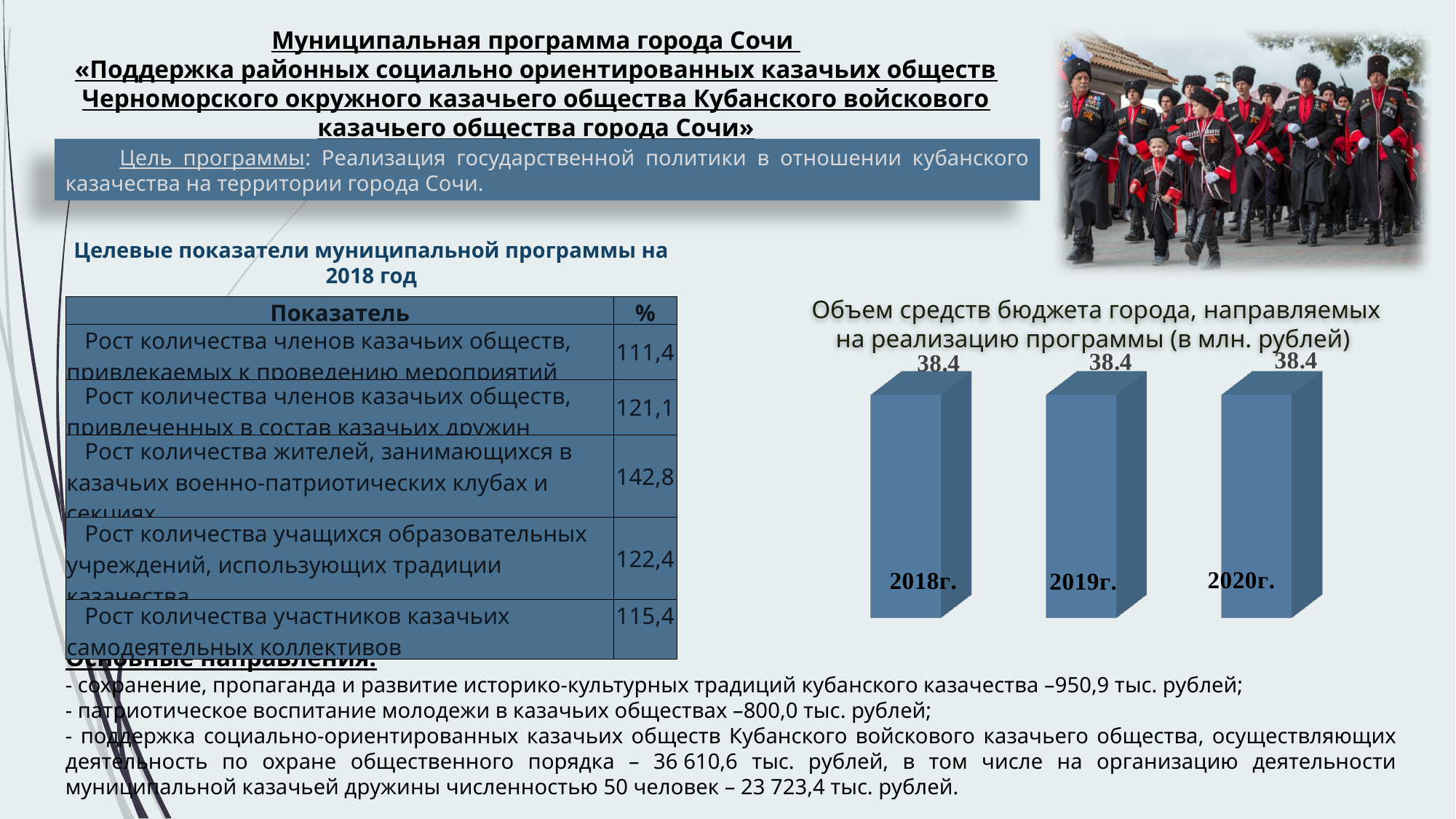
What kind of chart is shown on the slide? Bar chart In what units are the chart values given, according to the chart title? млн. рублей What is the value for 2019г. in the chart? 38.4 Is the value for 2019г. greater or less than 30? greater What is the value for 2020г. in the chart? 38.4 How many bars (years) are shown in the chart? 3 What is the value for 2018г. in the chart? 38.4 What is the title of the chart? Объем средств бюджета города, направляемых на реализацию программы (в млн. рублей) What is the difference between the values for 2020г. and 2018г.? 0 Do the values rise, fall or stay the same from 2018г. to 2020г.? Stay the same